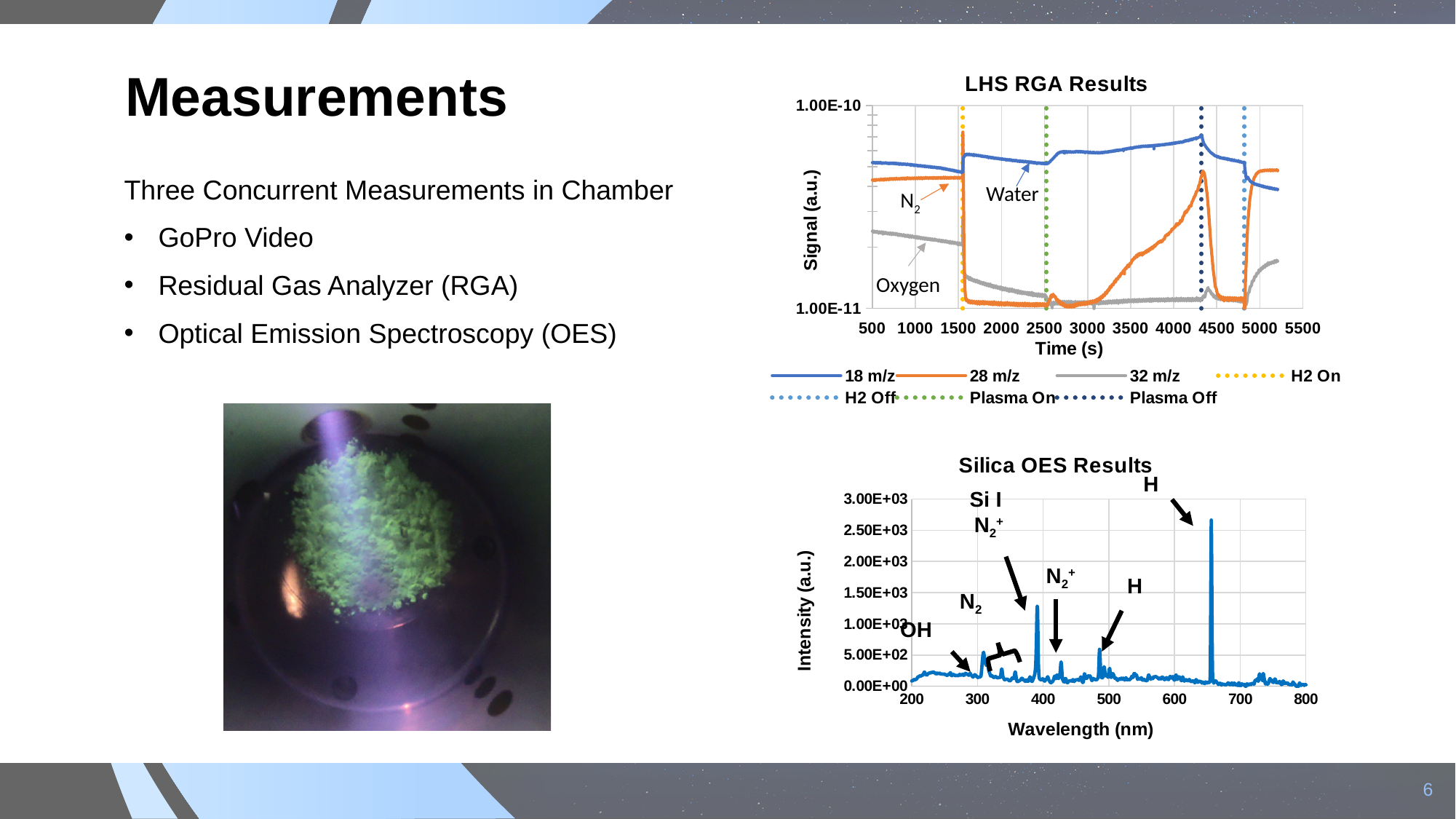
In the "LHS RGA Results" chart, is the 18 m/z signal at 1000 s greater or less than 1.00E-10? less In the "Silica OES Results" chart, is the peak near 390 nm greater or less than 1.50E+03? less In the "LHS RGA Results" chart, which series is annotated as "Water"? 18 m/z In the "LHS RGA Results" chart, does the 28 m/z signal rise or fall between 3000 s and 4300 s? rise How many series does the legend of the "LHS RGA Results" chart list? 7 In the "LHS RGA Results" chart, which series has the lowest signal at 1000 s? 32 m/z What kind of chart is the "LHS RGA Results" chart? line chart In the "Silica OES Results" chart, is the tallest peak (labeled H, near 650 nm) greater or less than 2.50E+03? greater What is the x-axis label of the "LHS RGA Results" chart? Time (s) In the "Silica OES Results" chart, which labeled peak has the highest intensity? H In the "LHS RGA Results" chart, which series has the highest signal at 1000 s? 18 m/z What kind of chart is the "Silica OES Results" chart? line chart